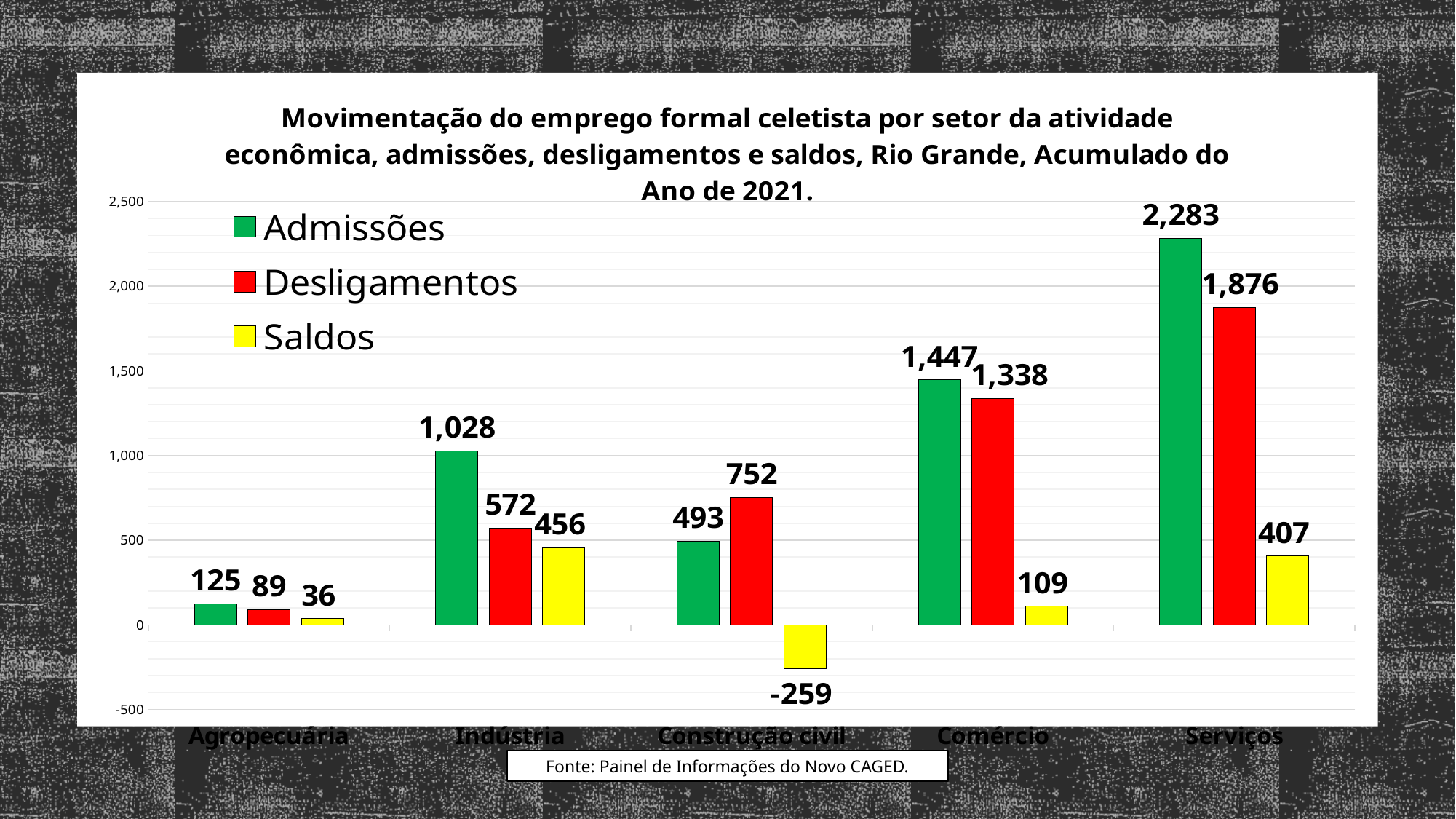
Which colour represents Saldos in the chart? Yellow What is the value of Admissões for Serviços? 2,283 How many series does the legend list? 3 Which sector has the highest Admissões value? Serviços Which is larger for Construção civil, Admissões or Desligamentos? Desligamentos What is the value of Saldos for Construção civil? -259 Which sector has the lowest Saldos value? Construção civil What is the value of Desligamentos for Comércio? 1,338 What kind of chart is shown on the slide? Bar chart What is the difference between Admissões and Desligamentos for Indústria? 456 How many sectors are shown on the x axis? 5 Is the Admissões value for Comércio greater or less than 1,000? greater